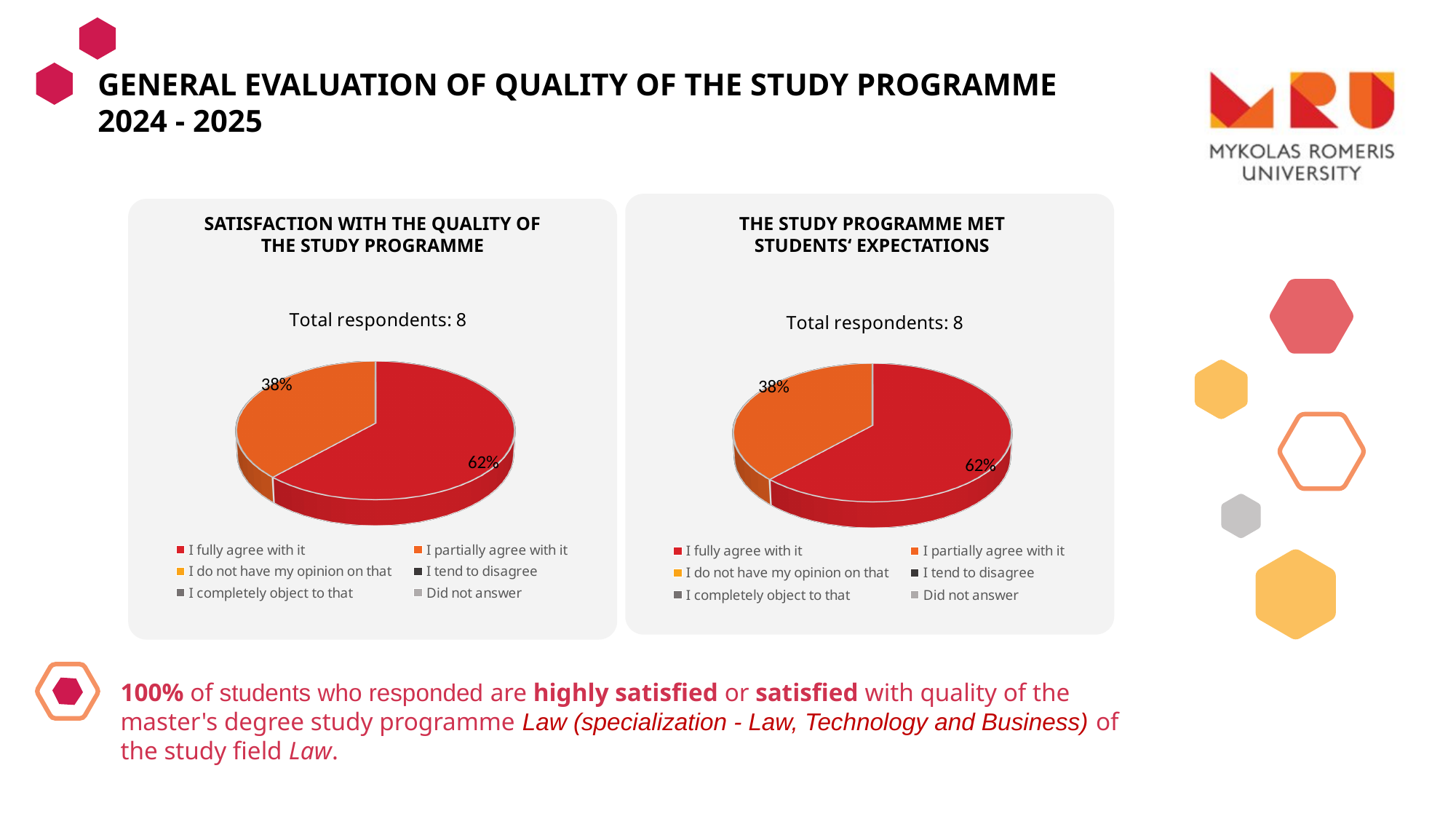
How many total respondents are reported for the 'The study programme met students' expectations' chart? 8 In the 'Satisfaction with the quality of the study programme' chart, what share of respondents partially agree with it? 38% How many slices are visible in the 'Satisfaction with the quality of the study programme' pie chart? 2 In the 'The study programme met students' expectations' chart, what share of respondents fully agree with it? 62% In the 'The study programme met students' expectations' chart, which is larger: 'I fully agree with it' or 'I partially agree with it'? I fully agree with it How many entries does the legend list in the 'The study programme met students' expectations' chart? 6 In the 'Satisfaction with the quality of the study programme' chart, which response has the largest share? I fully agree with it In the 'The study programme met students' expectations' chart, what share of respondents partially agree with it? 38% What kind of chart is used in the 'Satisfaction with the quality of the study programme' panel? Pie chart In the 'The study programme met students' expectations' chart, which response has the largest share? I fully agree with it In the 'Satisfaction with the quality of the study programme' chart, what is the difference in percentage points between 'I fully agree with it' and 'I partially agree with it'? 24 percentage points In the 'Satisfaction with the quality of the study programme' chart, what share of respondents fully agree with it? 62%